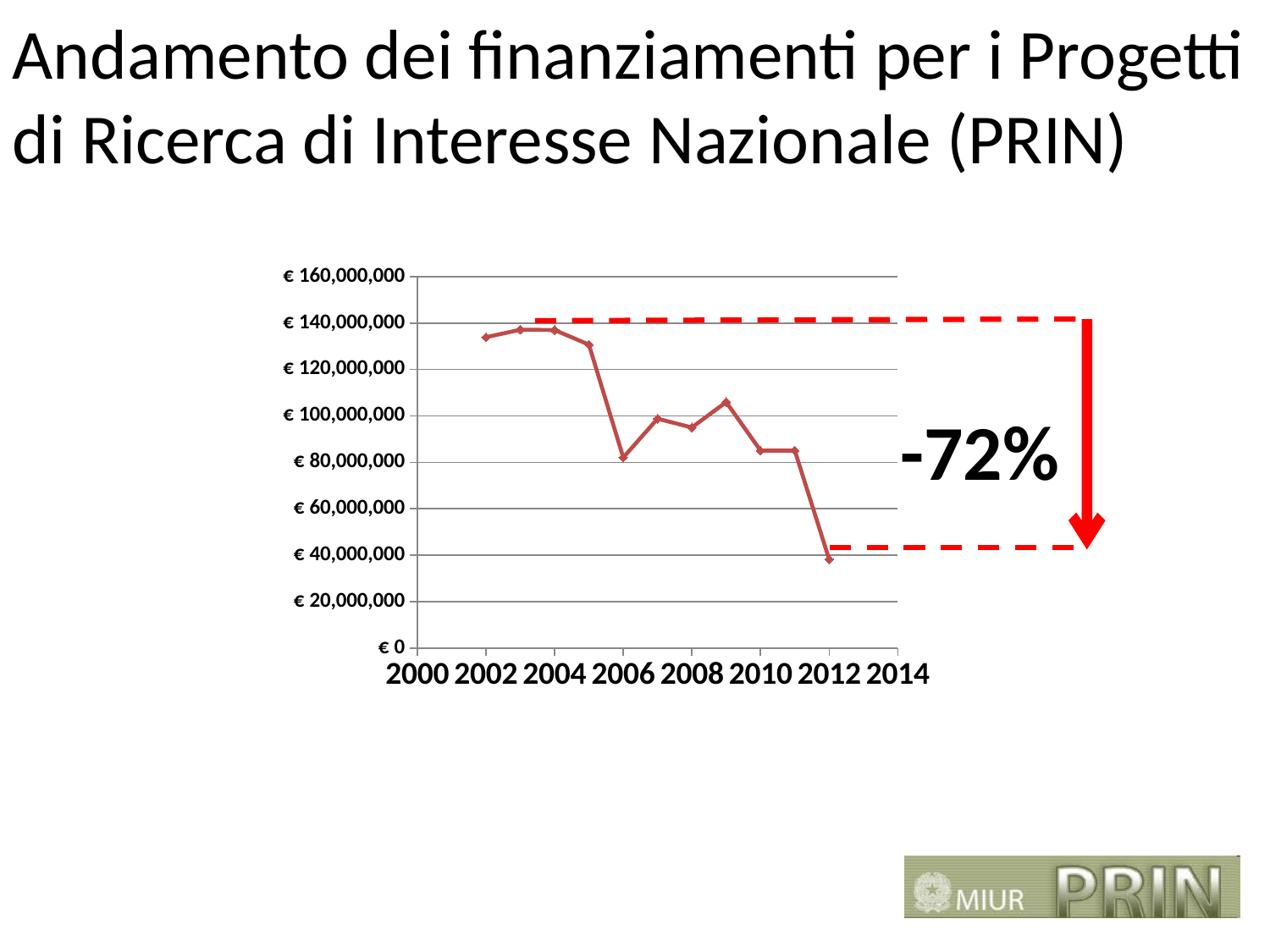
Is the funding value for 2002 greater or less than € 120,000,000? greater What is the highest value shown on the vertical axis? € 160,000,000 Is the funding value for 2006 greater or less than € 100,000,000? less What kind of chart is shown on the slide? line chart Which year has the lowest funding value on the chart? 2012 Is the funding value for 2012 greater or less than € 60,000,000? less What percentage change is annotated next to the red arrow on the chart? -72% How many data points are plotted on the line? 11 Which year has the larger funding value, 2006 or 2009? 2009 Overall, do the PRIN funding values rise or fall from 2002 to 2012? fall Which year has the larger funding value, 2002 or 2012? 2002